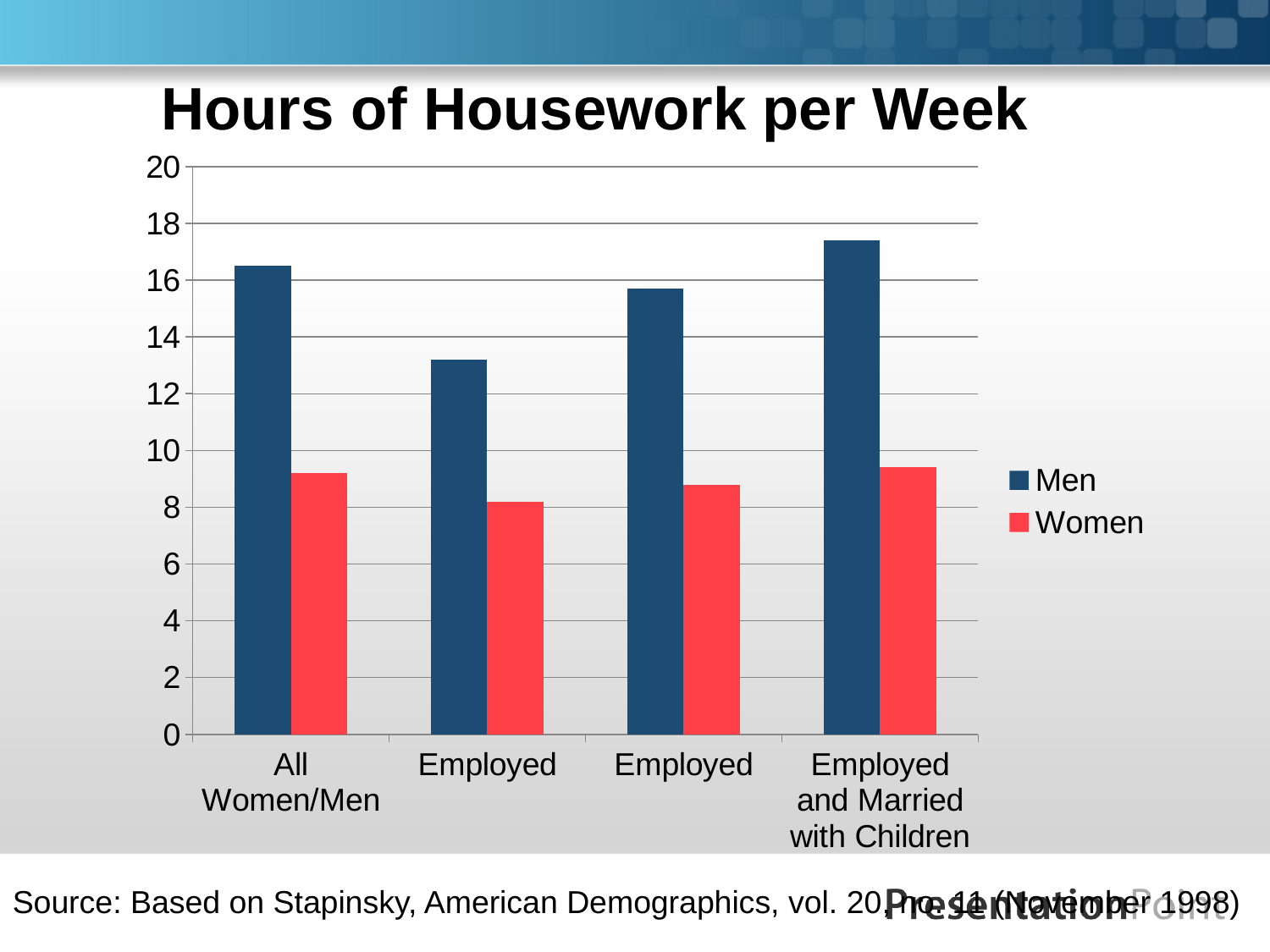
Is the value for Women in the All Women/Men category greater or less than 10? less Is the value for Men in the All Women/Men category greater or less than 16? greater How many series does the legend list? 2 Is the value for Men in the second category (Employed) greater or less than 14? less What is the title of the chart? Hours of Housework per Week What kind of chart is shown on the slide? Bar chart Which colour represents the Women series in the legend? Red Which category has the highest value for Men? Employed and Married with Children Which category has the lowest value for Men? Employed (second category) How many categories are shown on the x axis? 4 In the Employed and Married with Children category, which is larger, the value for Men or for Women? Men In the All Women/Men category, which is larger, the value for Men or for Women? Men